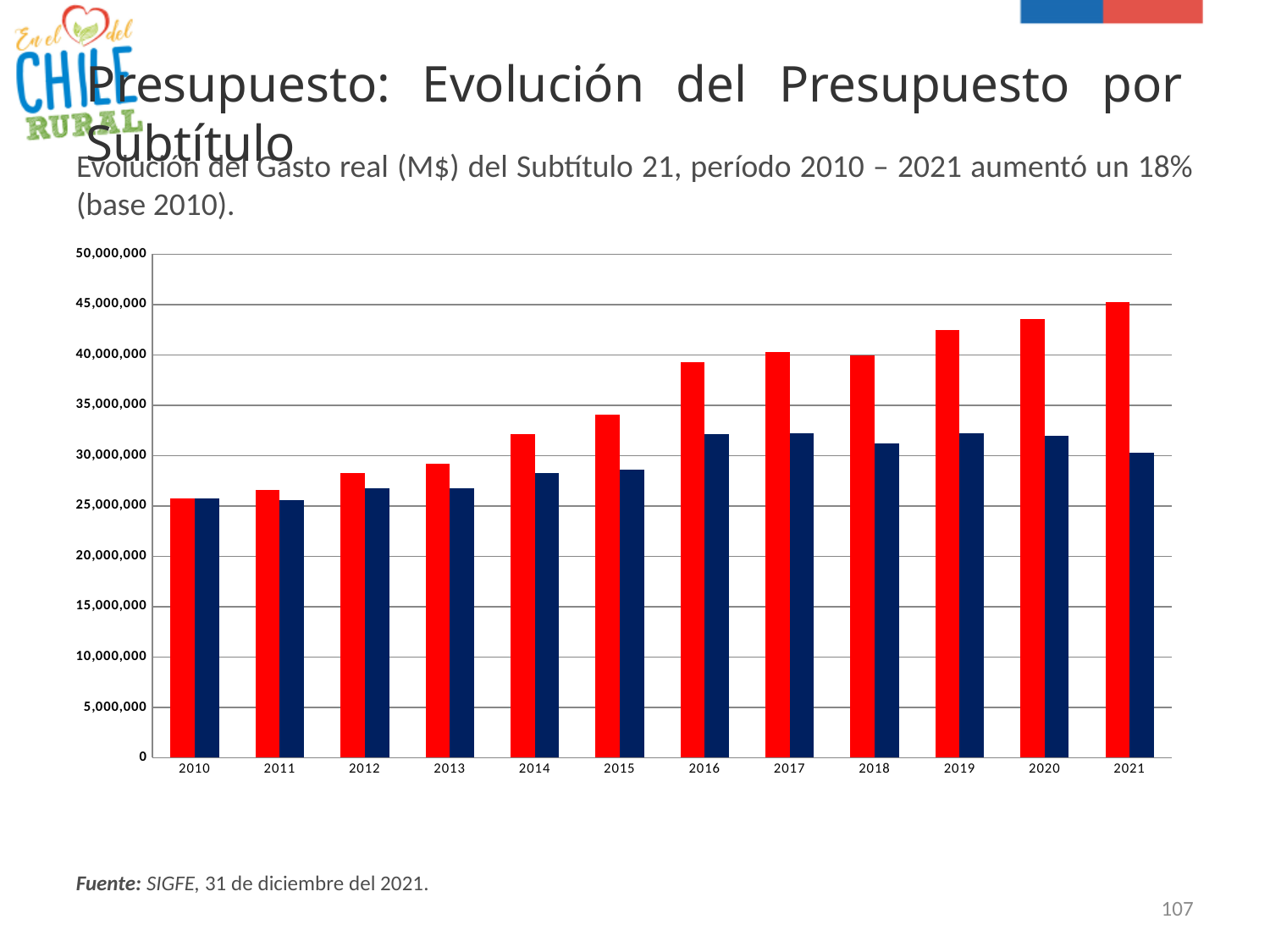
Is the value of the dark blue bar for 2017 greater or less than 30,000,000? greater Is the value of the dark blue bar for 2010 greater or less than 20,000,000? greater Do the red bars generally rise or fall from 2010 to 2021? rise Is the value of the red bar for 2016 greater or less than 35,000,000? greater What kind of chart is shown on the slide? bar chart How many years are shown on the x axis of the chart? 12 In 2021, which bar is taller, the red bar or the dark blue bar? the red bar What is the highest value shown on the y axis of the chart? 50,000,000 Which year has the tallest red bar? 2021 Which year has the shortest red bar? 2010